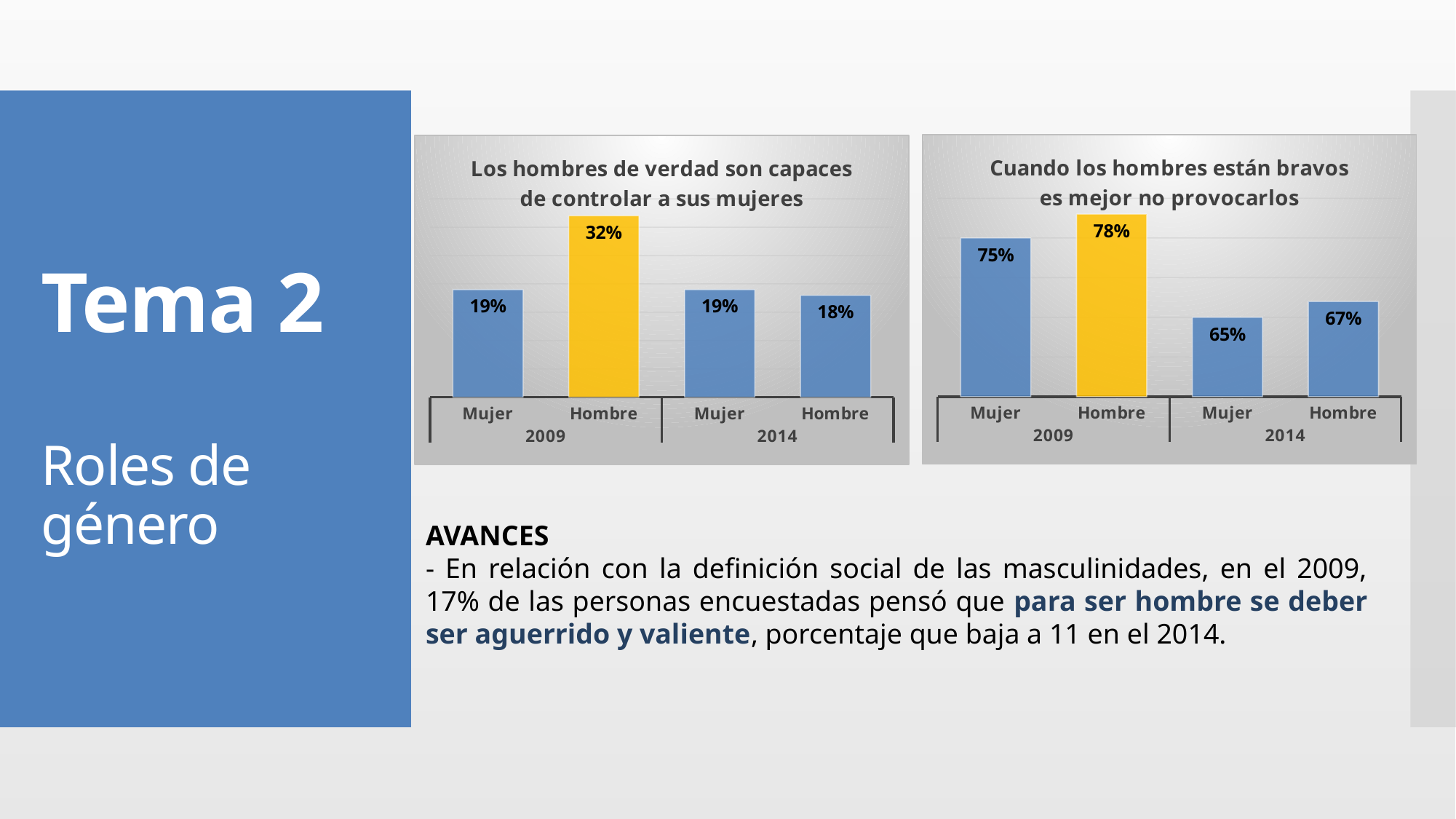
In the chart titled 'Los hombres de verdad son capaces de controlar a sus mujeres', what is the difference between Hombre 2009 and Hombre 2014? 14% In the chart titled 'Cuando los hombres están bravos es mejor no provocarlos', what is the value for Mujer in 2009? 75% In the chart titled 'Los hombres de verdad son capaces de controlar a sus mujeres', what is the value for Hombre in 2009? 32% In the chart titled 'Cuando los hombres están bravos es mejor no provocarlos', which is larger, Hombre 2009 or Hombre 2014? Hombre 2009 In the chart titled 'Los hombres de verdad son capaces de controlar a sus mujeres', how many bars are plotted? 4 In the chart titled 'Los hombres de verdad son capaces de controlar a sus mujeres', what is the value for Hombre in 2014? 18% In the chart titled 'Cuando los hombres están bravos es mejor no provocarlos', which bar is the lowest? Mujer 2014 In the chart titled 'Cuando los hombres están bravos es mejor no provocarlos', what is the value for Mujer in 2014? 65% In the chart titled 'Los hombres de verdad son capaces de controlar a sus mujeres', which bar is coloured yellow? Hombre 2009 What kind of chart is the chart titled 'Cuando los hombres están bravos es mejor no provocarlos'? Bar chart In the chart titled 'Cuando los hombres están bravos es mejor no provocarlos', what is the difference between Hombre 2009 and Mujer 2009? 3% In the chart titled 'Los hombres de verdad son capaces de controlar a sus mujeres', which bar is the highest? Hombre 2009